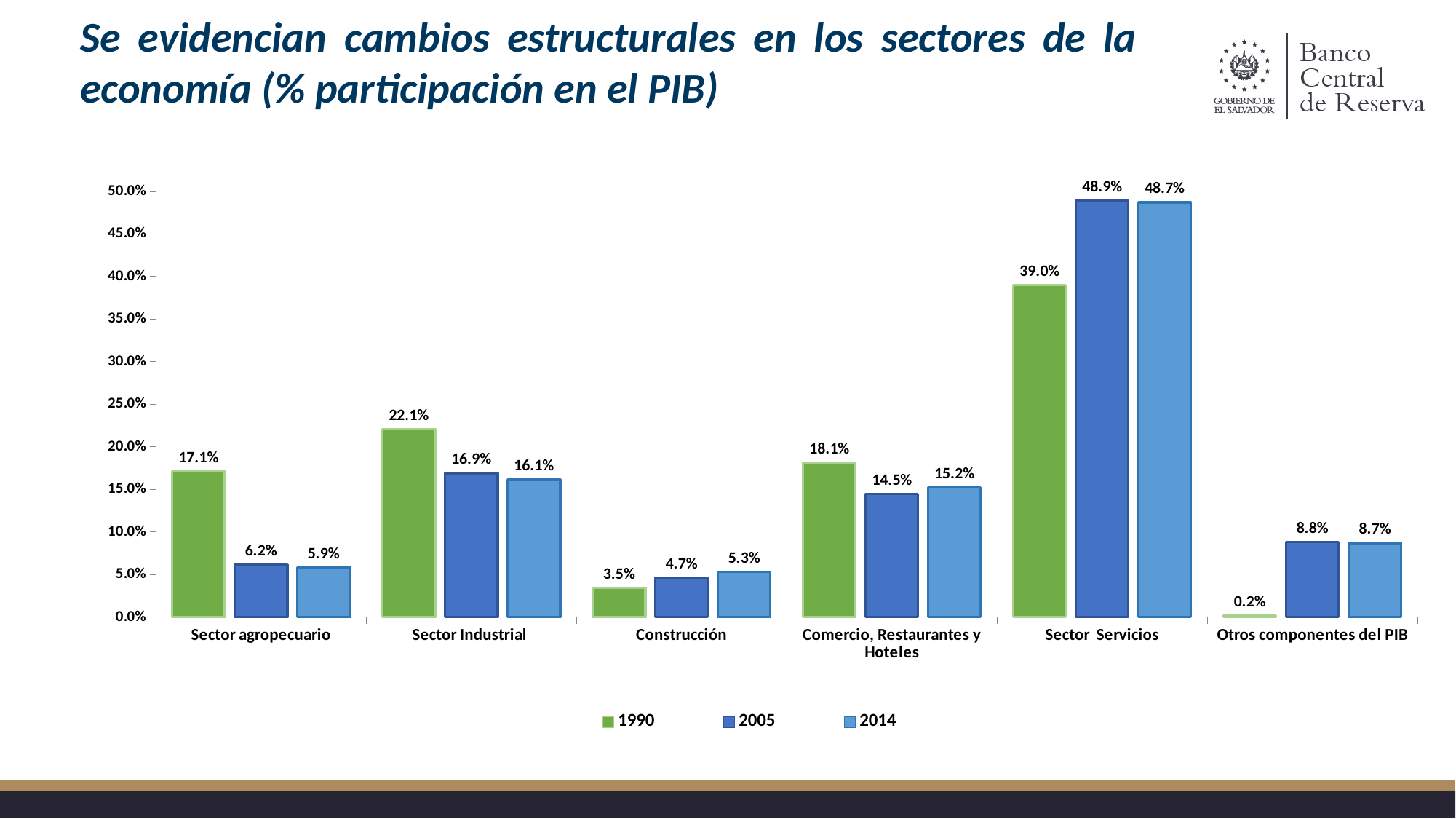
What was the share of Construcción in 2005? 4.7% What was the share of Sector Servicios in 2014? 48.7% What was the share of Sector agropecuario in 1990? 17.1% Did the share of Construcción rise or fall from 1990 to 2014? Rise Which was larger for Comercio, Restaurantes y Hoteles: the 2005 value or the 2014 value? 2014 Which years are listed in the legend? 1990, 2005, 2014 Which sector had the highest share in 2005? Sector Servicios What kind of chart is shown on the slide? Bar chart By how many percentage points did the share of Sector Industrial fall from 1990 to 2014? 6.0% How many series does the legend list? 3 How many sectors or categories are shown on the x axis? 6 Which category had the lowest share in 1990? Otros componentes del PIB